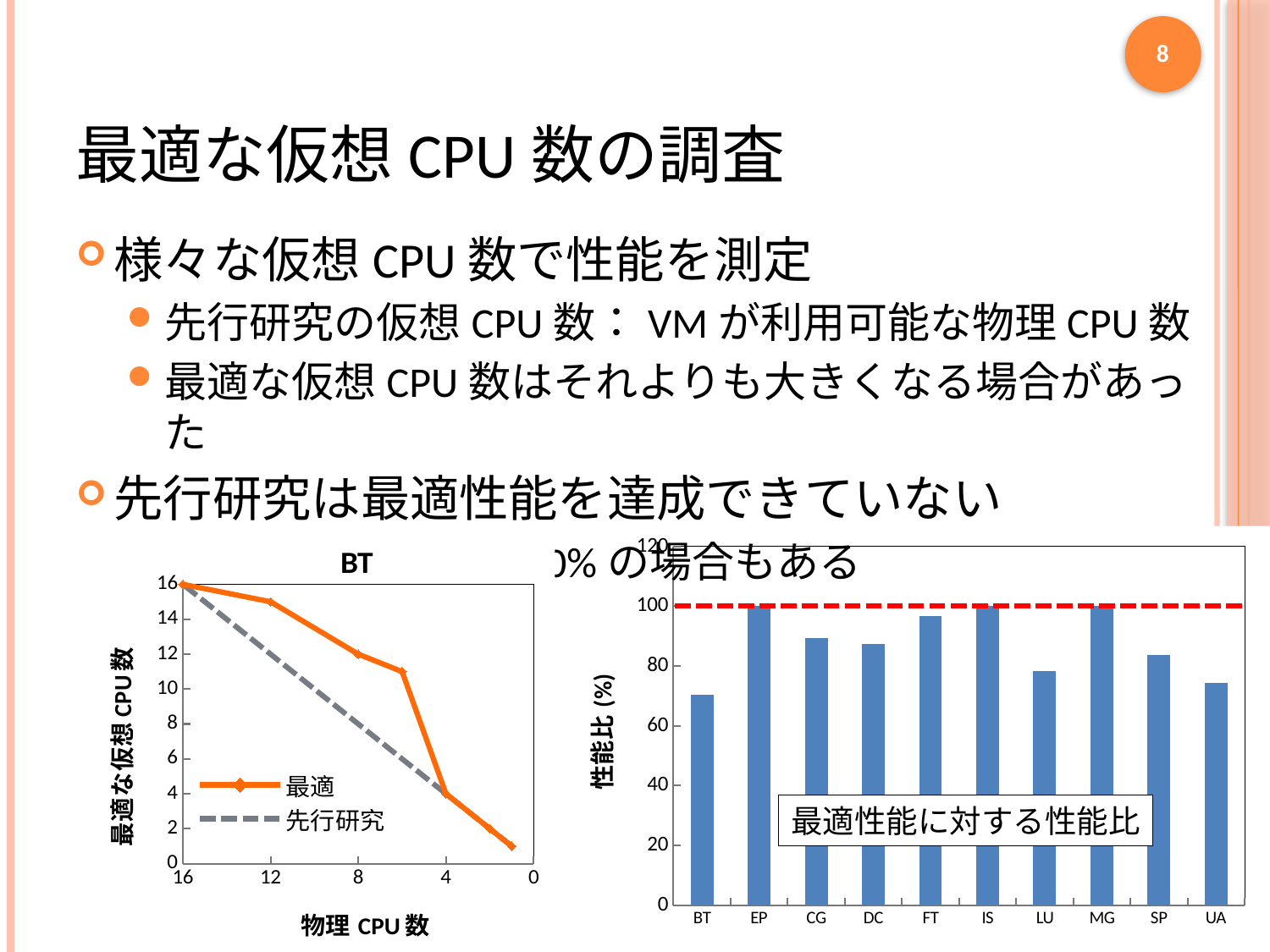
In the chart on the right, which is larger, the value for FT or the value for UA? FT In the chart titled BT, what is the 最適 value when 物理 CPU 数 is 16? 16 In the chart titled BT, what is the 最適 value when 物理 CPU 数 is 4? 4 In the chart on the right, how many categories are shown on the x axis? 10 In the chart titled BT, how many series does the legend list? 2 In the chart titled BT, what is the label of the y axis? 最適な仮想 CPU 数 In the chart on the right, which category has the lowest 性能比? BT In the chart on the right, is the value for BT greater or less than 80? less What kind of chart is the chart on the right of the slide? bar chart What kind of chart is the chart titled BT on the left of the slide? line chart In the chart on the right, is the value for SP greater or less than 80? greater